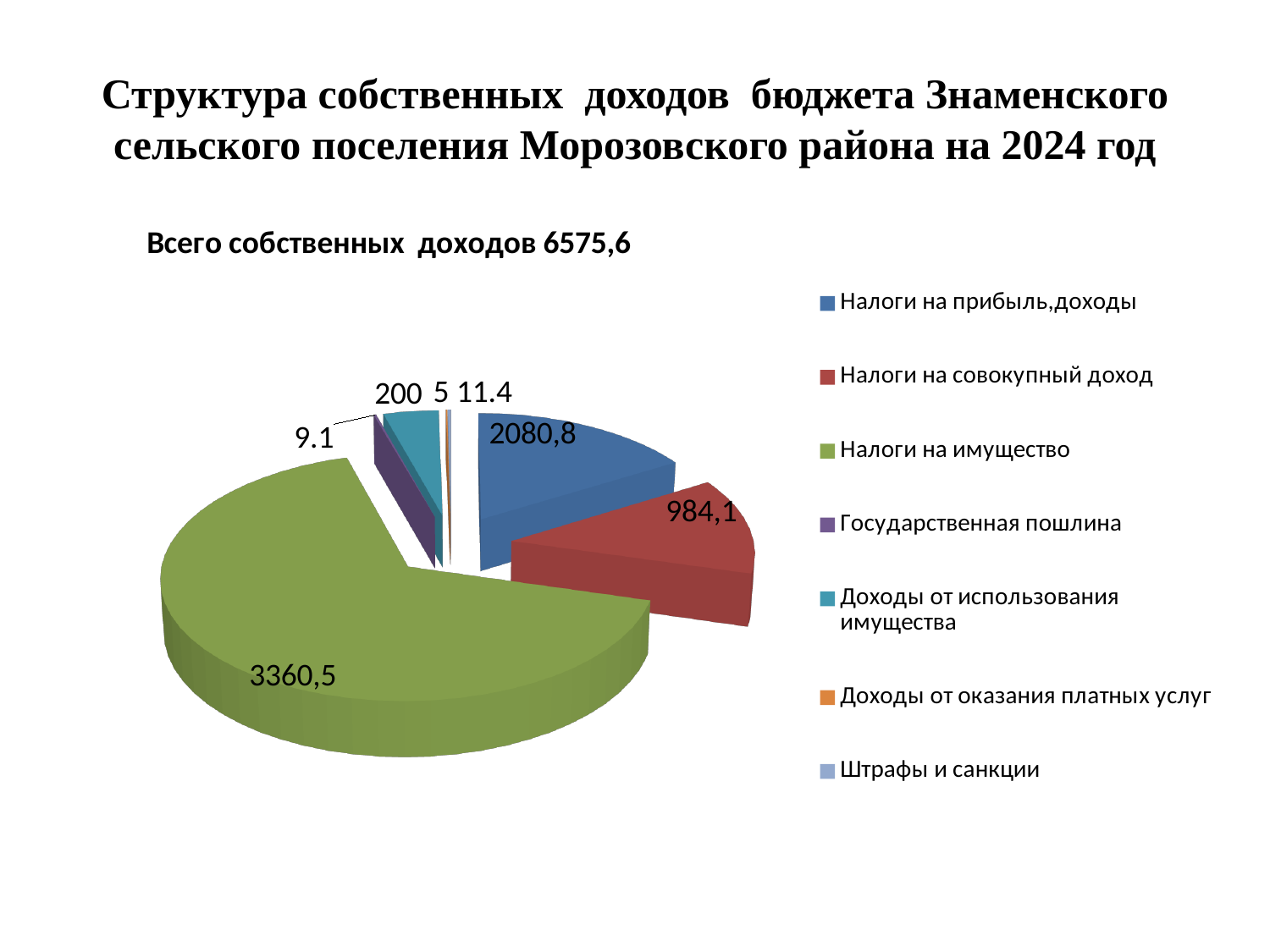
Which is larger: Налоги на прибыль,доходы or Налоги на совокупный доход? Налоги на прибыль,доходы Which category has the smallest value in the pie chart? Доходы от оказания платных услуг What is the value shown for Налоги на прибыль,доходы? 2080,8 What is the value shown for Доходы от использования имущества? 200 What is the value shown for Налоги на совокупный доход? 984,1 Which category has the largest slice of the pie? Налоги на имущество What is the value shown for Налоги на имущество? 3360,5 What is the difference between the values for Налоги на имущество and Налоги на прибыль,доходы? 1279,7 What is the value shown for Штрафы и санкции? 11.4 What type of chart is shown on the slide? pie chart How many categories does the legend of the pie chart list? 7 What is the value shown for Государственная пошлина? 9.1